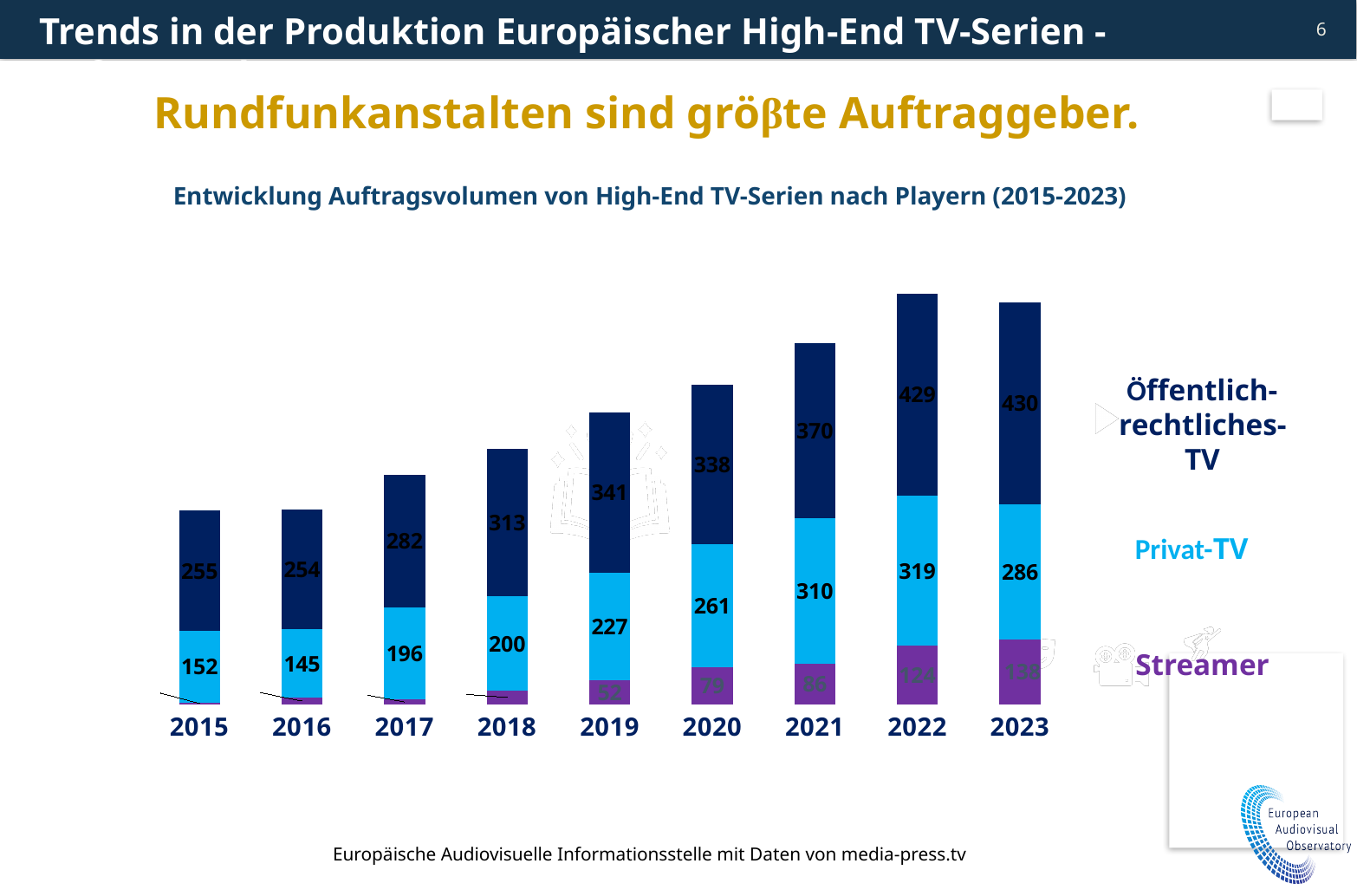
What is the value for Öffentlich-rechtliches TV in 2022? 429 How much higher is the Öffentlich-rechtliches TV value in 2023 than in 2015? 175 In which year is the Privat-TV value lowest? 2016 What is the value for Privat-TV in 2021? 310 In which year is the Privat-TV value highest? 2022 How many series does the chart show? 3 What is the value for Streamer in 2020? 79 What is the total of the stacked bar for 2021? 766 Do the Streamer values rise or fall from 2019 to 2022? Rise How many years are shown on the x axis? 9 In 2019, which is larger: Öffentlich-rechtliches TV or Privat-TV? Öffentlich-rechtliches TV What kind of chart is shown on the slide? Stacked bar chart